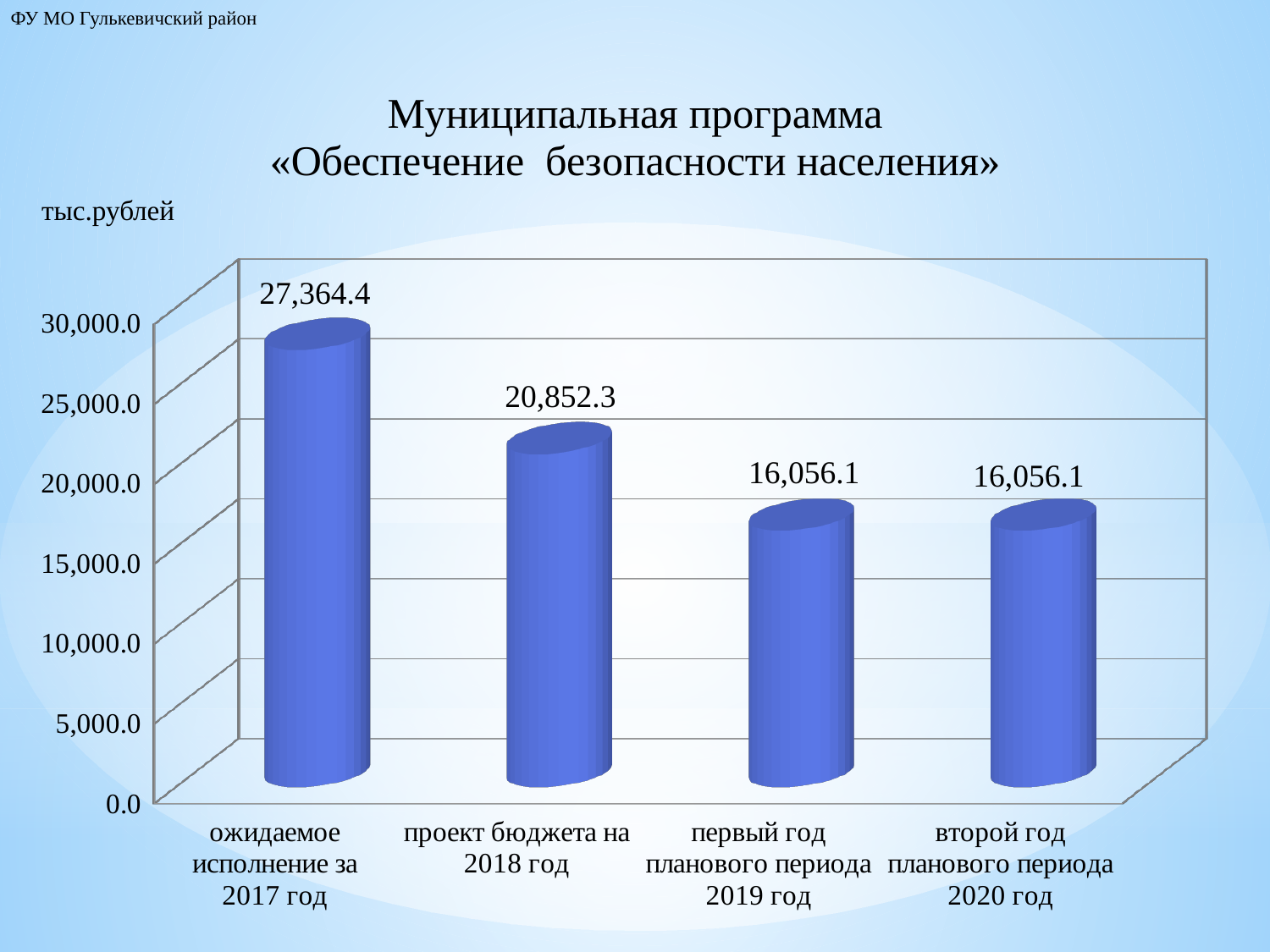
What kind of chart is shown on the slide? bar chart Do the values rise or fall from 2017 год to 2019 год? fall How many categories are shown in the chart? 4 Is the value for первый год планового периода 2019 год larger than, smaller than, or equal to the value for второй год планового периода 2020 год? equal What is the value for ожидаемое исполнение за 2017 год? 27,364.4 Which is larger: the value for проект бюджета на 2018 год or the value for второй год планового периода 2020 год? проект бюджета на 2018 год What is the value for второй год планового периода 2020 год? 16,056.1 What is the difference between the value for проект бюджета на 2018 год and the value for 2019 год? 4,796.2 What is the value for проект бюджета на 2018 год? 20,852.3 What is the value for первый год планового периода 2019 год? 16,056.1 What is the difference between the value for 2017 год and the value for проект бюджета на 2018 год? 6,512.1 Which category has the highest value? ожидаемое исполнение за 2017 год